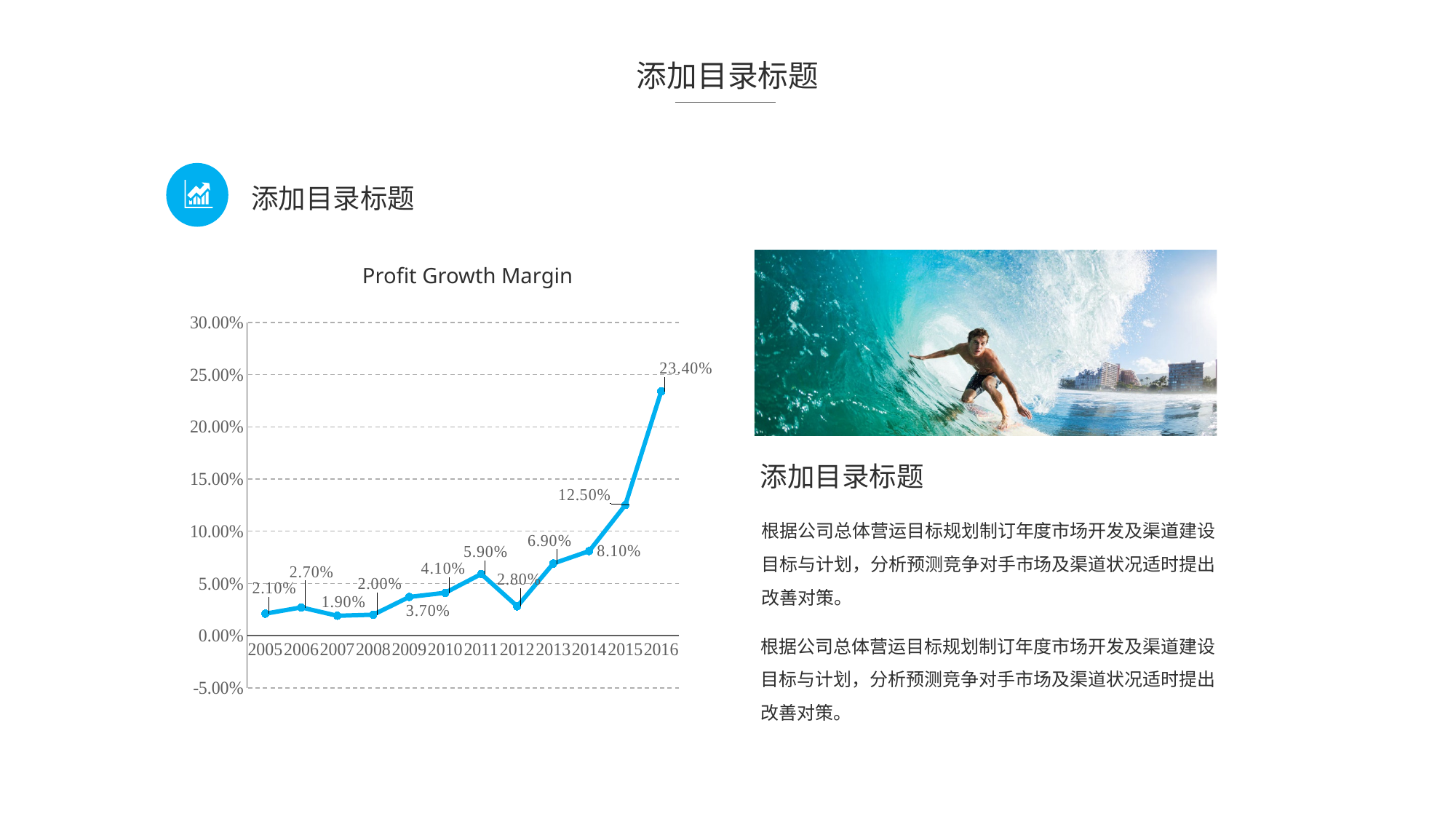
Is the Profit Growth Margin for 2015 greater or less than 10.00%? greater What is the difference between the Profit Growth Margin in 2016 and in 2015? 10.90% Which year has the lowest Profit Growth Margin? 2007 What is the Profit Growth Margin for 2012? 2.80% What is the Profit Growth Margin for 2016? 23.40% Which year has the highest Profit Growth Margin? 2016 What is the Profit Growth Margin for 2009? 3.70% What kind of chart is the Profit Growth Margin chart? line chart What is the difference between the Profit Growth Margin in 2013 and in 2012? 4.10% Which year has a higher Profit Growth Margin, 2011 or 2012? 2011 How many years are plotted on the Profit Growth Margin chart? 12 What is the title of the chart on the slide? Profit Growth Margin